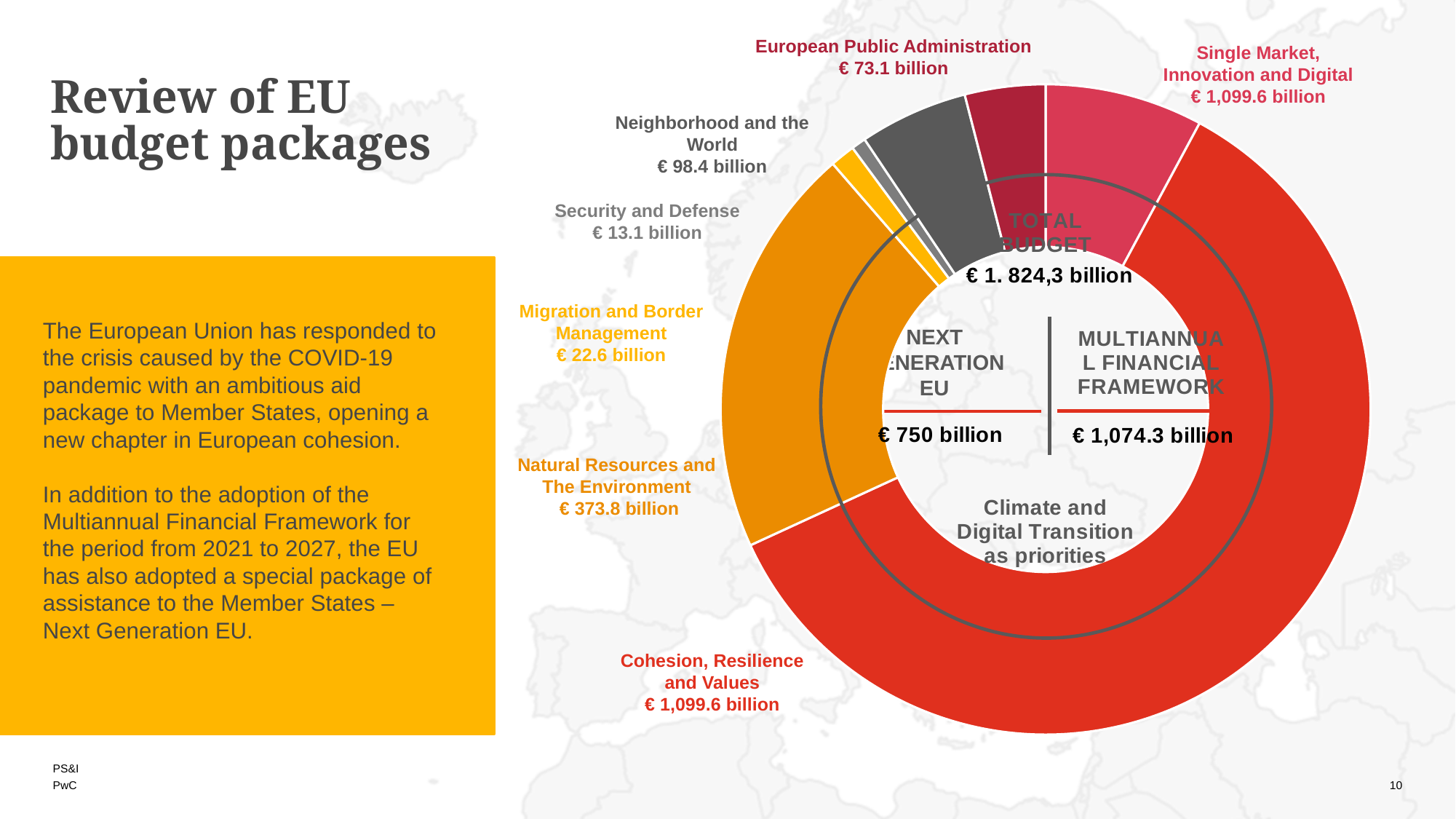
What is the value shown for Neighborhood and the World? € 98.4 billion What is the difference between Neighborhood and the World and European Public Administration? € 25.3 billion What total budget is printed in the centre of the chart? € 1. 824,3 billion How many labelled budget categories does the chart show? 7 What is the value shown for Security and Defense? € 13.1 billion What is the value shown for Natural Resources and The Environment? € 373.8 billion What is the difference between the Multiannual Financial Framework and Next Generation EU amounts? € 324.3 billion Which is larger, Natural Resources and The Environment or Neighborhood and the World? Natural Resources and The Environment What is the value shown for Cohesion, Resilience and Values? € 1,099.6 billion What is the value shown for Migration and Border Management? € 22.6 billion Which labelled segment has the smallest value? Security and Defense What value is shown for Next Generation EU? € 750 billion